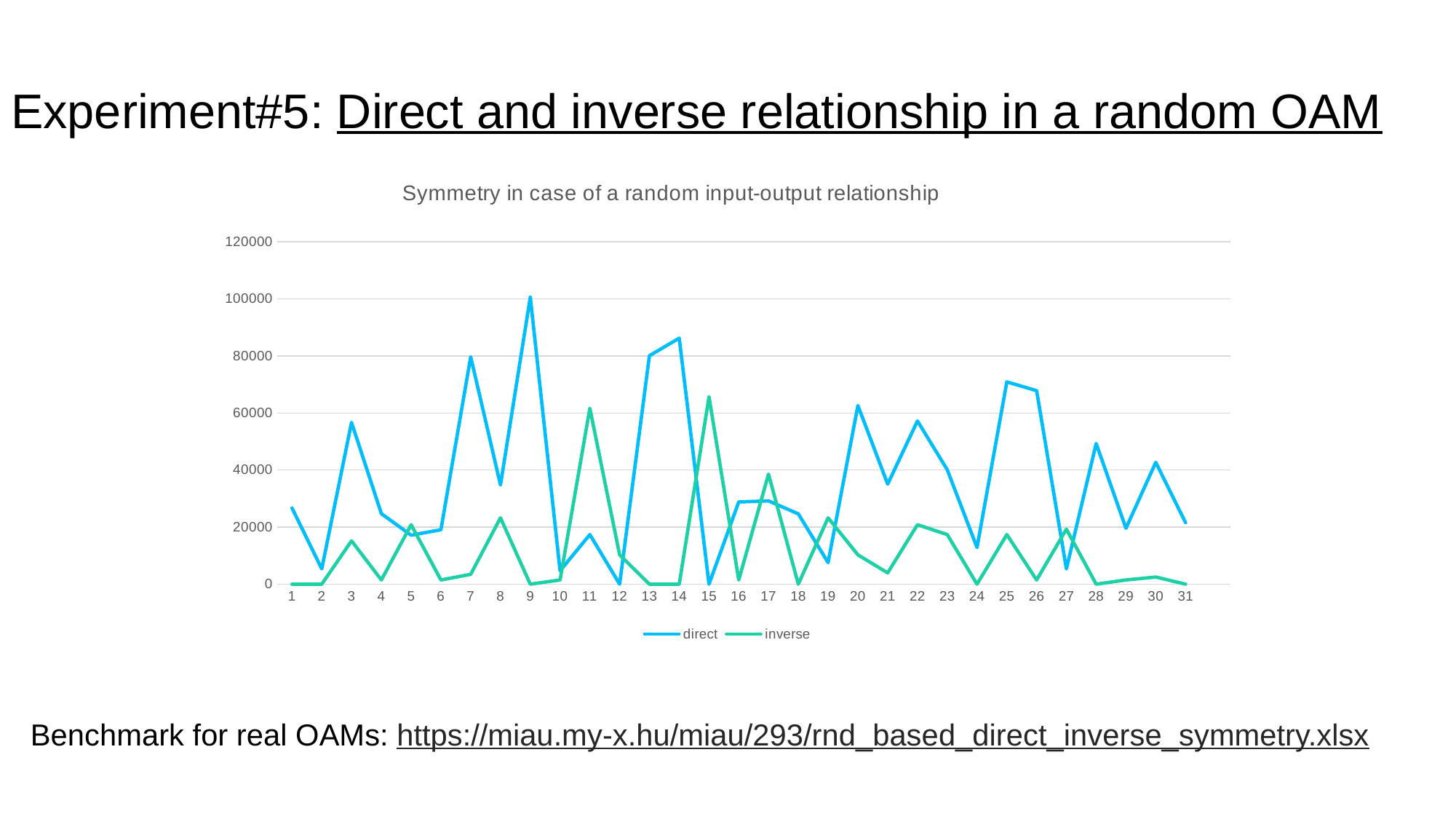
At point 11, which series has the larger value, direct or inverse? inverse Is the value of the direct series at point 12 greater or less than 20000? less What kind of chart is shown on the slide? line chart At which x-axis point does the inverse series reach its highest value? 15 Is the value of the inverse series at point 11 greater or less than 40000? greater How many series does the legend list? 2 What is the title of the chart? Symmetry in case of a random input-output relationship At which x-axis point does the direct series reach its highest value? 9 At point 20, which series has the larger value, direct or inverse? direct Is the value of the direct series at point 9 greater or less than 80000? greater How many points are plotted along the x axis for each series? 31